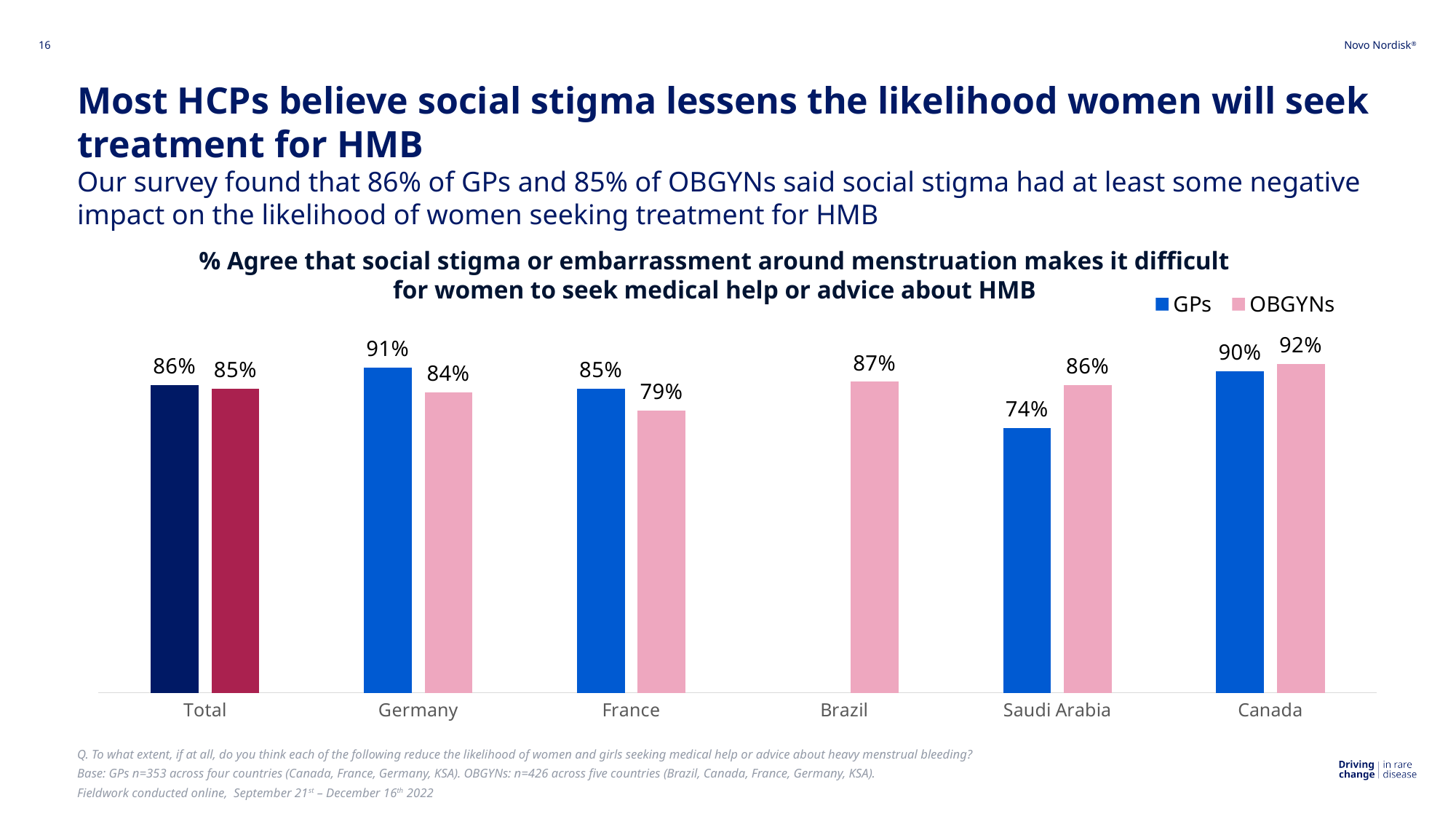
Which country has the lowest GPs value? Saudi Arabia Which country has the highest OBGYNs value? Canada How many categories are shown on the x axis? 6 What is the OBGYNs value for France? 79% Which country has no GPs bar shown? Brazil What kind of chart is shown on the slide? Bar chart How many series does the legend list? 2 What percentage of GPs in Germany agree that social stigma makes it difficult for women to seek medical help about HMB? 91% Which is larger for Canada, the GPs value or the OBGYNs value? OBGYNs What is the GPs value for Saudi Arabia? 74% What is the difference between the GPs and OBGYNs values for Saudi Arabia? 12% What is the OBGYNs value for Brazil? 87%